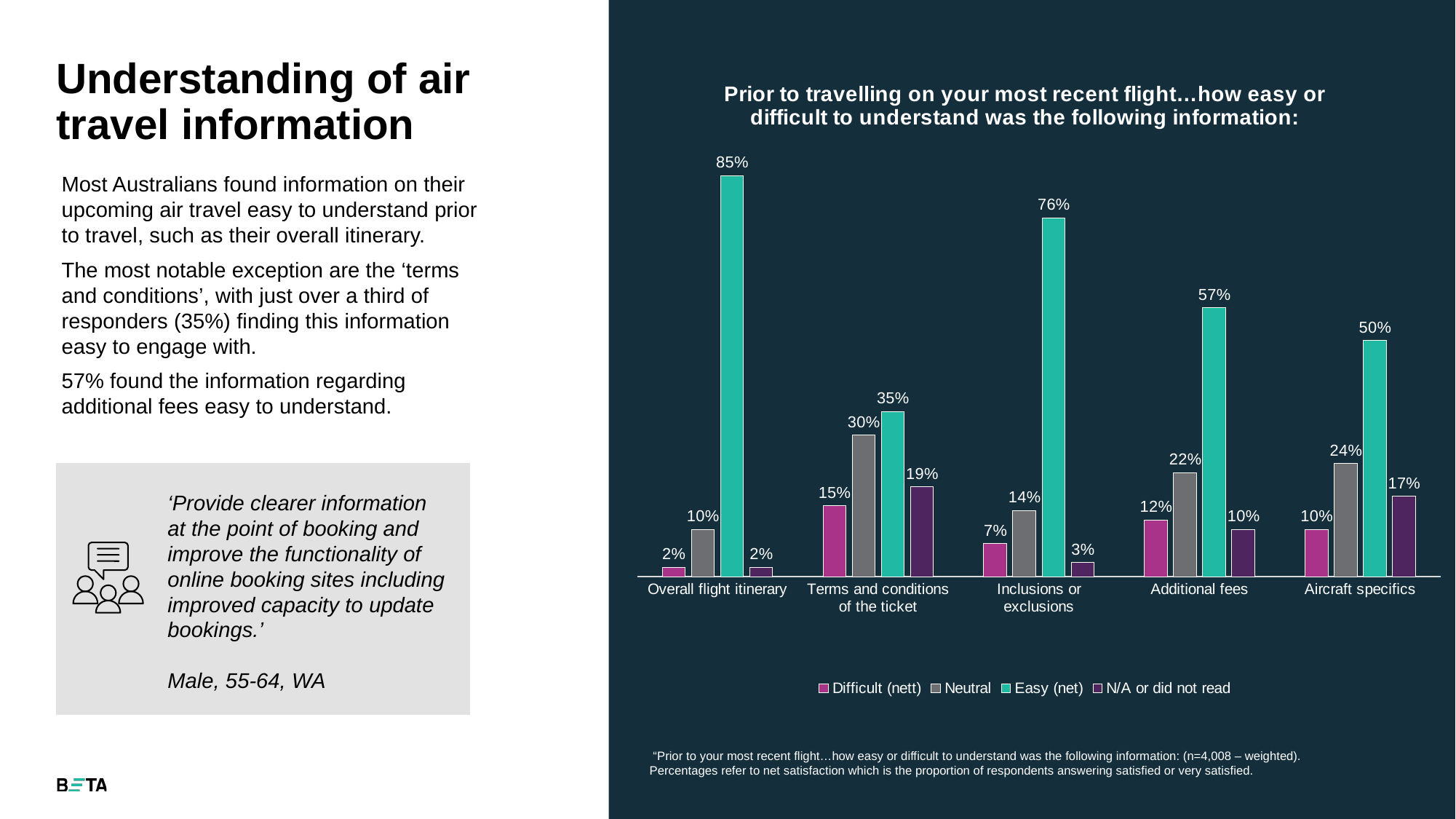
Which series is shown in teal? Easy (net) How many categories are shown on the x axis? 5 What is the Neutral value for Terms and conditions of the ticket? 30% What is the N/A or did not read value for Aircraft specifics? 17% What is the Easy (net) value for Overall flight itinerary? 85% What is the Difficult (nett) value for Additional fees? 12% What kind of chart is shown on the slide? Bar chart How many series does the legend list? 4 Which category has the highest Easy (net) value? Overall flight itinerary What is the difference between the Easy (net) values for Inclusions or exclusions and Additional fees? 19% Which category has the lowest Easy (net) value? Terms and conditions of the ticket Which is larger: the Difficult (nett) value for Terms and conditions of the ticket or for Inclusions or exclusions? Terms and conditions of the ticket